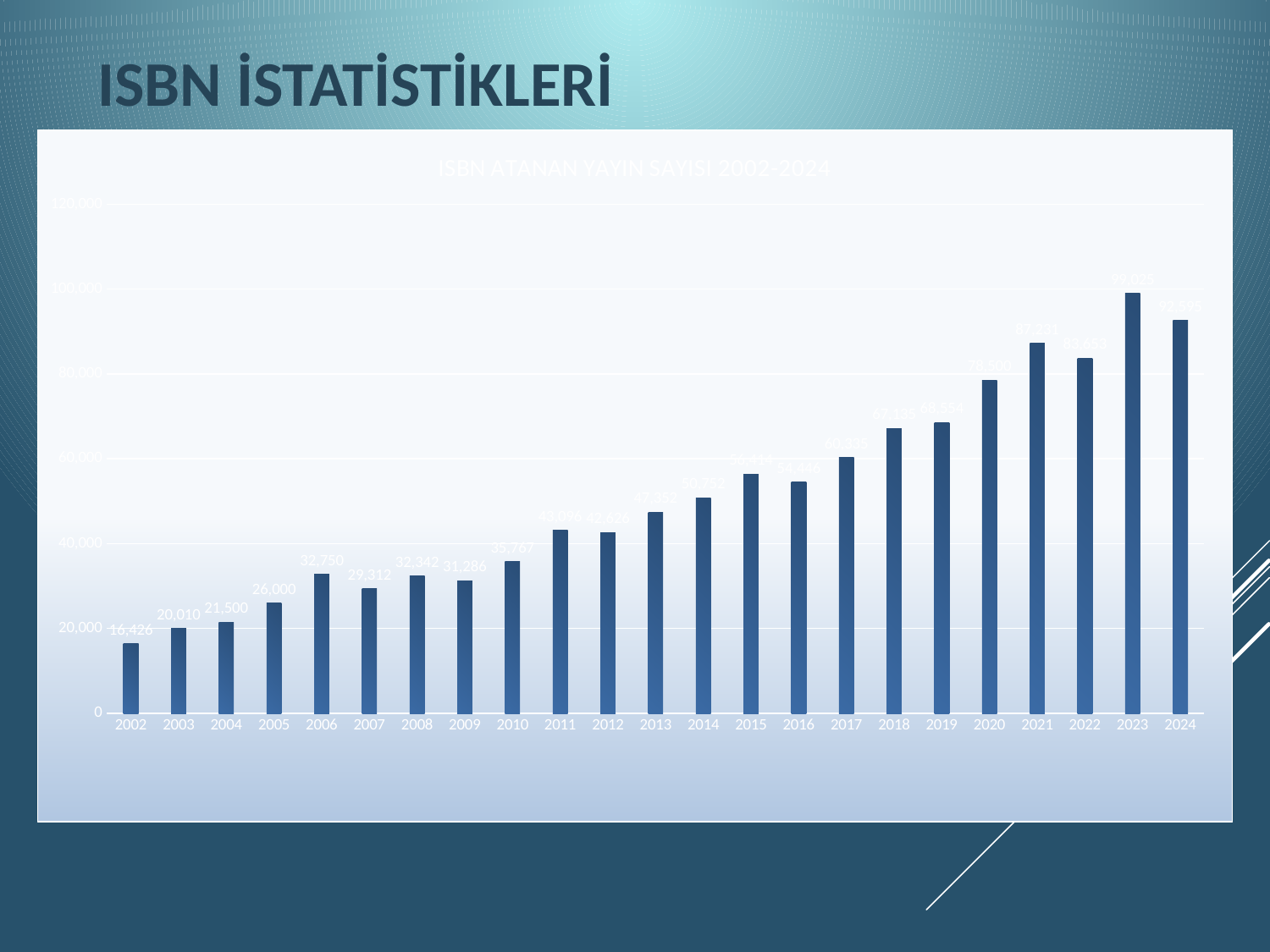
What is the title of the chart? ISBN ATANAN YAYIN SAYISI 2002-2024 Is the value for 2020 greater or less than 60,000? greater What is the value for 2006? 32,750 Which year has the lowest value? 2002 What is the value for 2002? 16,426 Which is larger, the value for 2023 or the value for 2024? 2023 What is the difference between the values for 2003 and 2002? 3,584 What is the value for 2005? 26,000 Do the values generally rise or fall from 2002 to 2024? rise How many years (bars) are plotted in the chart? 23 What type of chart is shown on the slide? bar chart Which year has the highest value? 2023